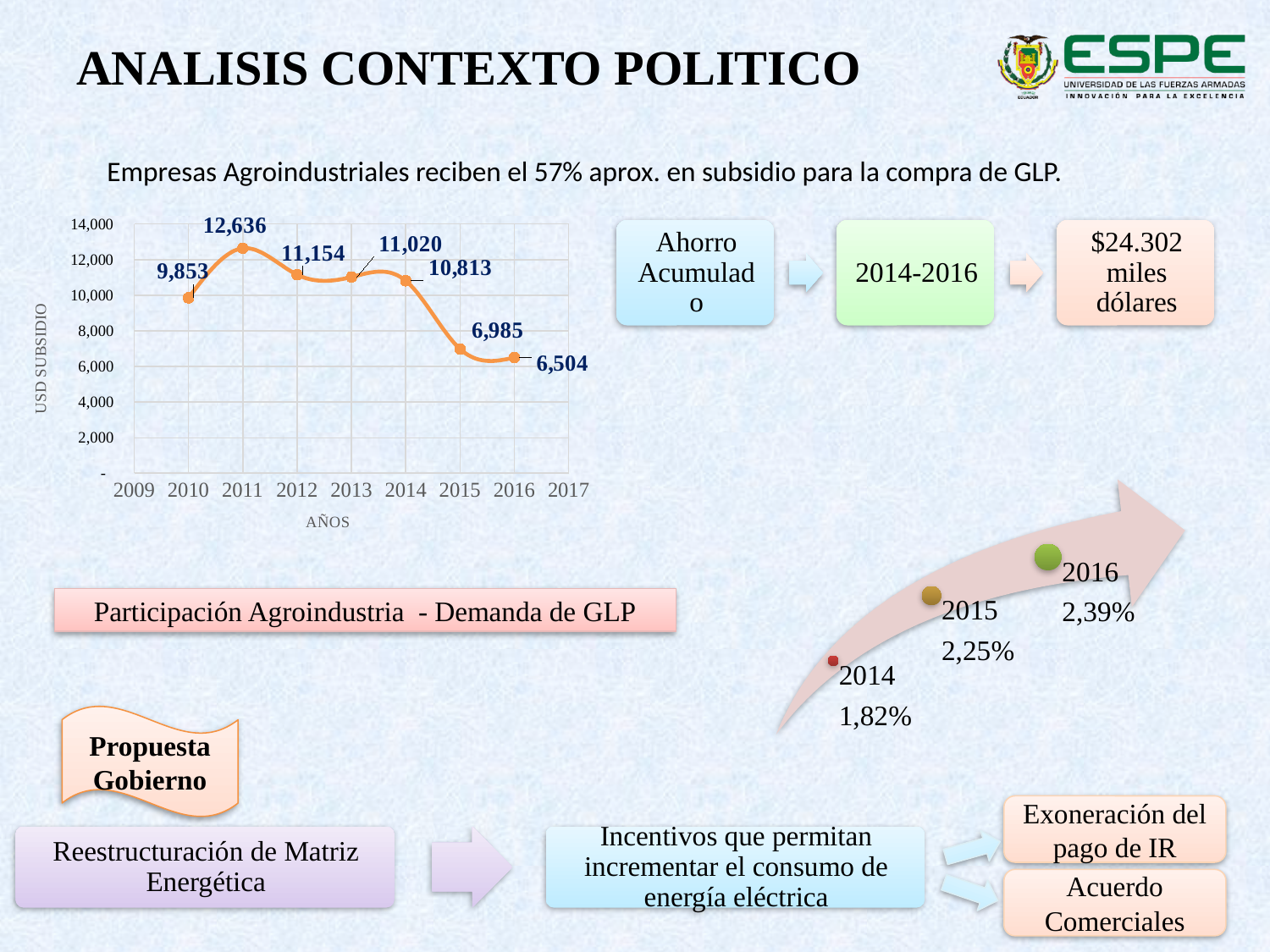
What type of chart is shown on the left of the slide? line chart What is the label of the horizontal axis of the line chart on the left? AÑOS What is the label of the vertical axis of the line chart on the left? USD SUBSIDIO In the line chart on the left, what is the difference between the 2011 value and the 2016 value? 6,132 In the line chart on the left, what is the USD subsidy value for 2010? 9,853 In the line chart on the left, which year has the highest subsidy value? 2011 In the line chart on the left, do the values generally rise or fall from 2011 to 2016? fall In the line chart on the left, what is the USD subsidy value for 2015? 6,985 In the line chart on the left, what is the USD subsidy value for 2011? 12,636 In the line chart on the left, how many data points are plotted? 7 In the line chart on the left, which year has the lowest subsidy value? 2016 In the line chart on the left, which is larger, the value for 2012 or the value for 2014? 2012